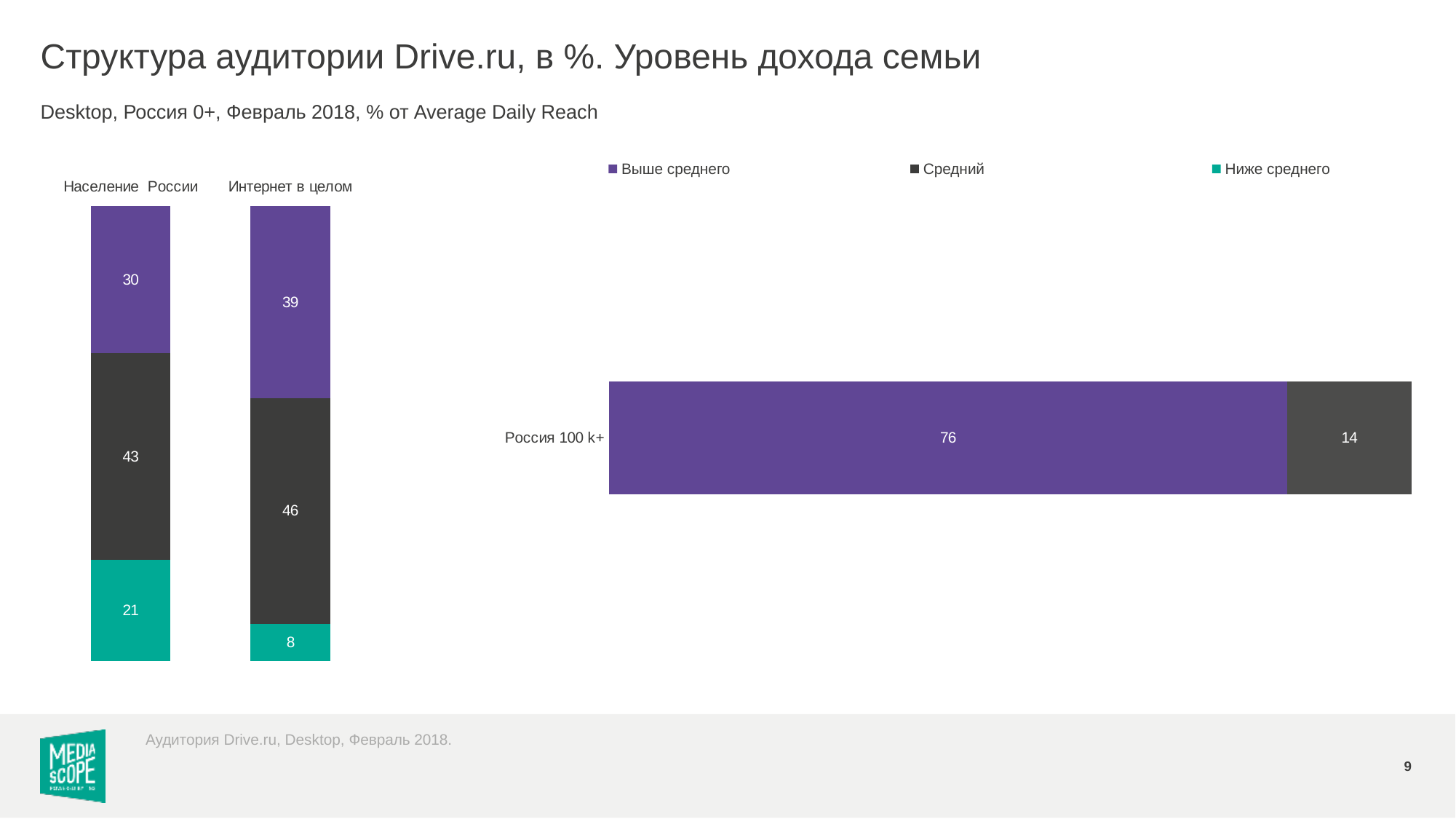
In the left chart, what is the value of 'Ниже среднего' for 'Интернет в целом'? 8 In the left chart, which segment is the largest for 'Население России'? Средний How many series does the legend list? 3 In the right chart, what is the value of 'Средний' for 'Россия 100 k+'? 14 What kind of chart is the right chart? Stacked bar chart In the left chart, which is larger: 'Выше среднего' for 'Население России' or for 'Интернет в целом'? Интернет в целом In the left chart, what is the total of the stacked bar for 'Интернет в целом'? 93 In the left chart, which segment is the smallest for 'Интернет в целом'? Ниже среднего In the left chart, what is the difference between the 'Ниже среднего' values for 'Население России' and 'Интернет в целом'? 13 In the left chart, what is the value of 'Средний' for 'Интернет в целом'? 46 In the left chart, what is the value of 'Выше среднего' for 'Население России'? 30 In the right chart, what is the value of 'Выше среднего' for 'Россия 100 k+'? 76